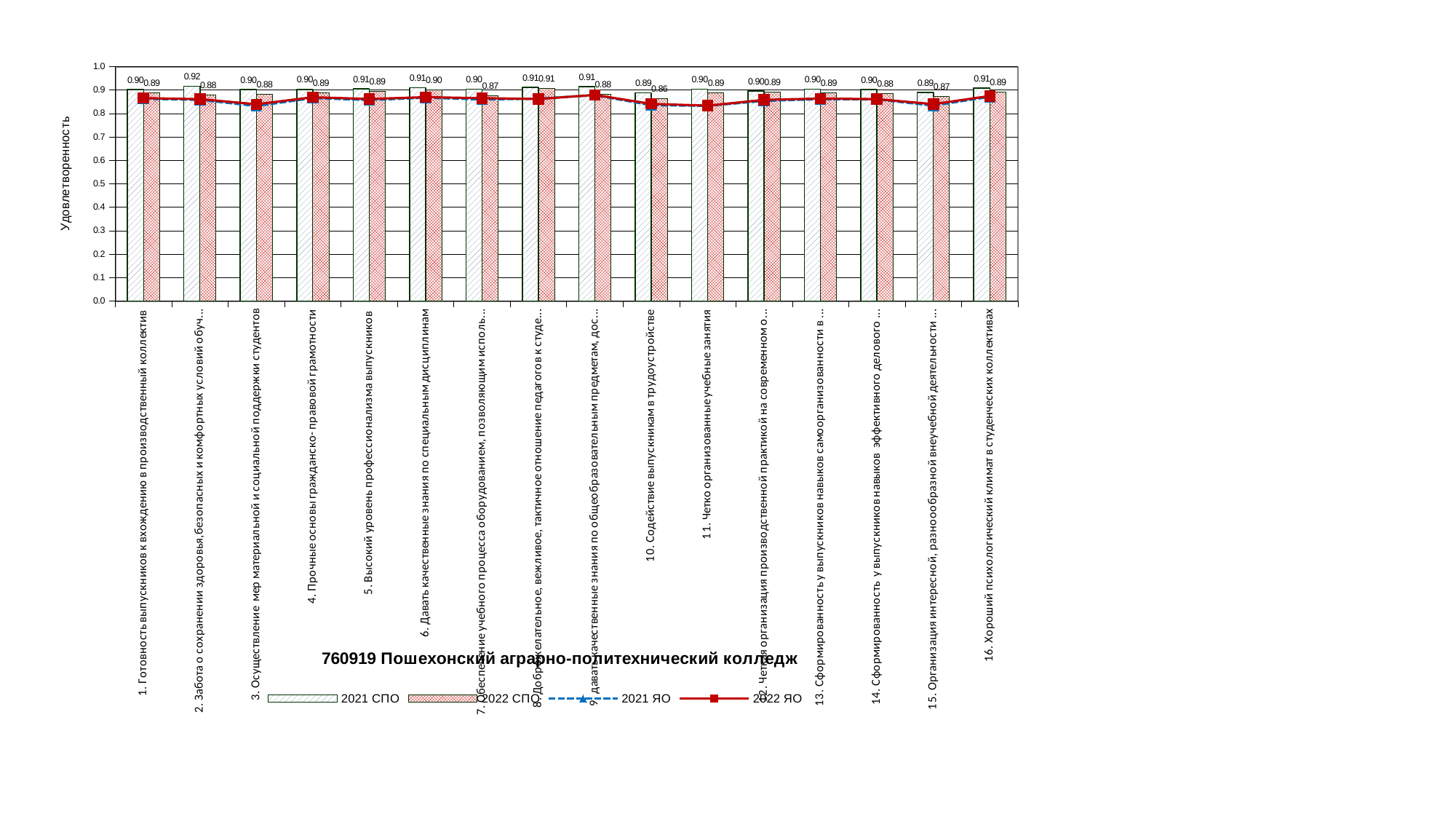
What kind of chart is this? Combined bar and line chart What is the value of the 2021 СПО bar for category "10. Содействие выпускникам в трудоустройстве"? 0.89 What is the title of the chart? 760919 Пошехонский аграрно-политехнический колледж How many series does the legend list? 4 Is the 2021 СПО value for category "1. Готовность выпускников к вхождению в производственный коллектив" greater or less than 0.8? greater What is the value of the 2021 СПО bar for category "16. Хороший психологический климат в студенческих коллективах"? 0.91 What is the value of the 2022 СПО bar for category "6. Давать качественные знания по специальным дисциплинам"? 0.90 What is the value of the 2022 СПО bar for category "10. Содействие выпускникам в трудоустройстве"? 0.86 Which category has the lowest 2022 СПО value? 10. Содействие выпускникам в трудоустройстве How many categories are shown on the x axis? 16 What is the difference between the 2021 СПО and 2022 СПО values for category "10. Содействие выпускникам в трудоустройстве"? 0.03 For category "5. Высокий уровень профессионализма выпускников", which is larger: the 2021 СПО value or the 2022 СПО value? 2021 СПО